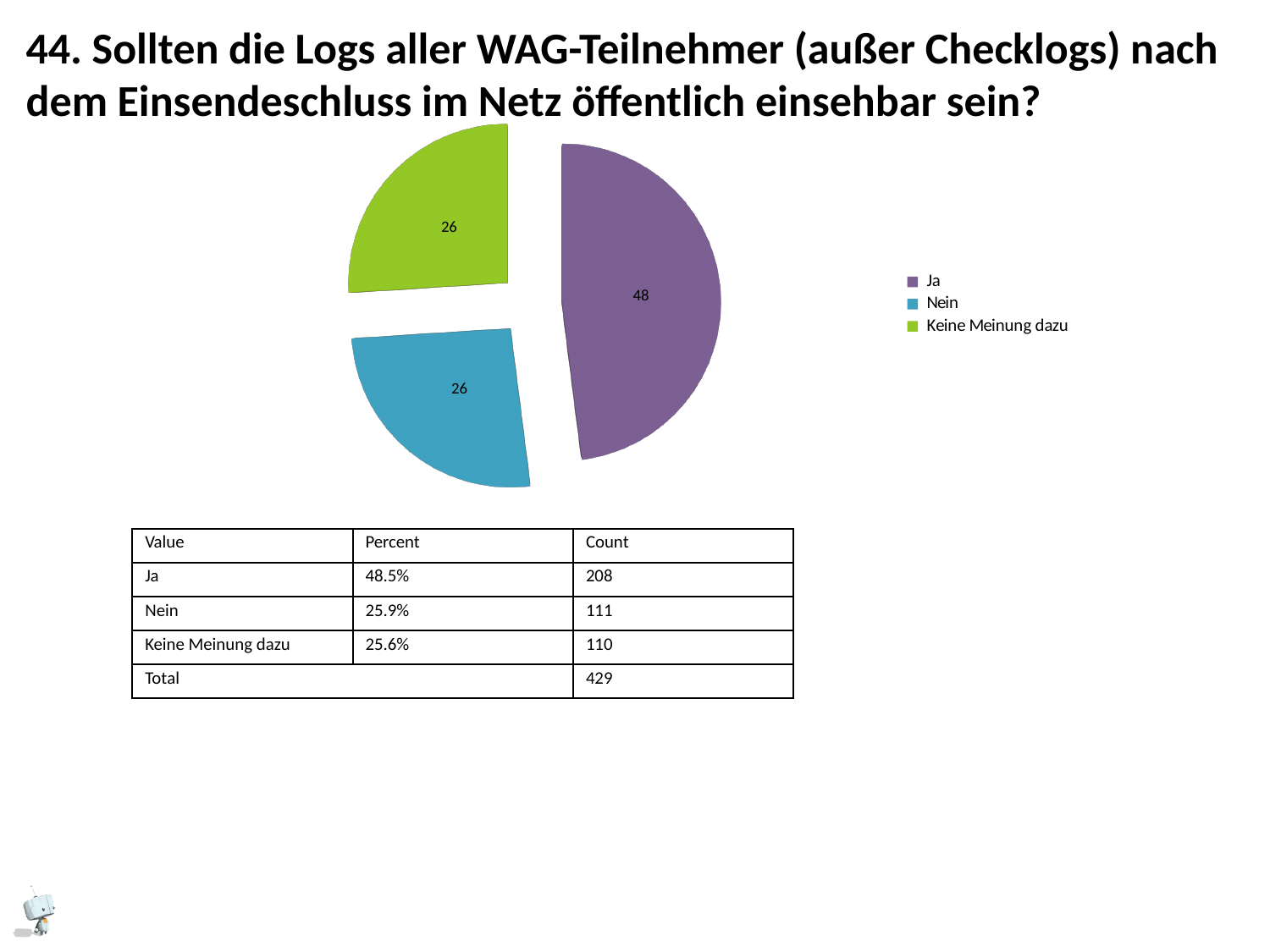
Which legend entry of the pie chart is shown in green? Keine Meinung dazu How many entries does the legend of the pie chart list? 3 Which legend entry of the pie chart is shown in purple? Ja Which slice of the pie chart is the largest? Ja How many slices does the pie chart have? 3 What value is labelled on the 'Nein' slice of the pie chart? 26 What value is labelled on the 'Ja' slice of the pie chart? 48 What is the difference between the labelled values of the 'Ja' slice and the 'Nein' slice in the pie chart? 22 What kind of chart is shown on the slide? pie chart What value is labelled on the 'Keine Meinung dazu' slice of the pie chart? 26 Which is larger in the pie chart, the 'Ja' slice or the 'Nein' slice? Ja